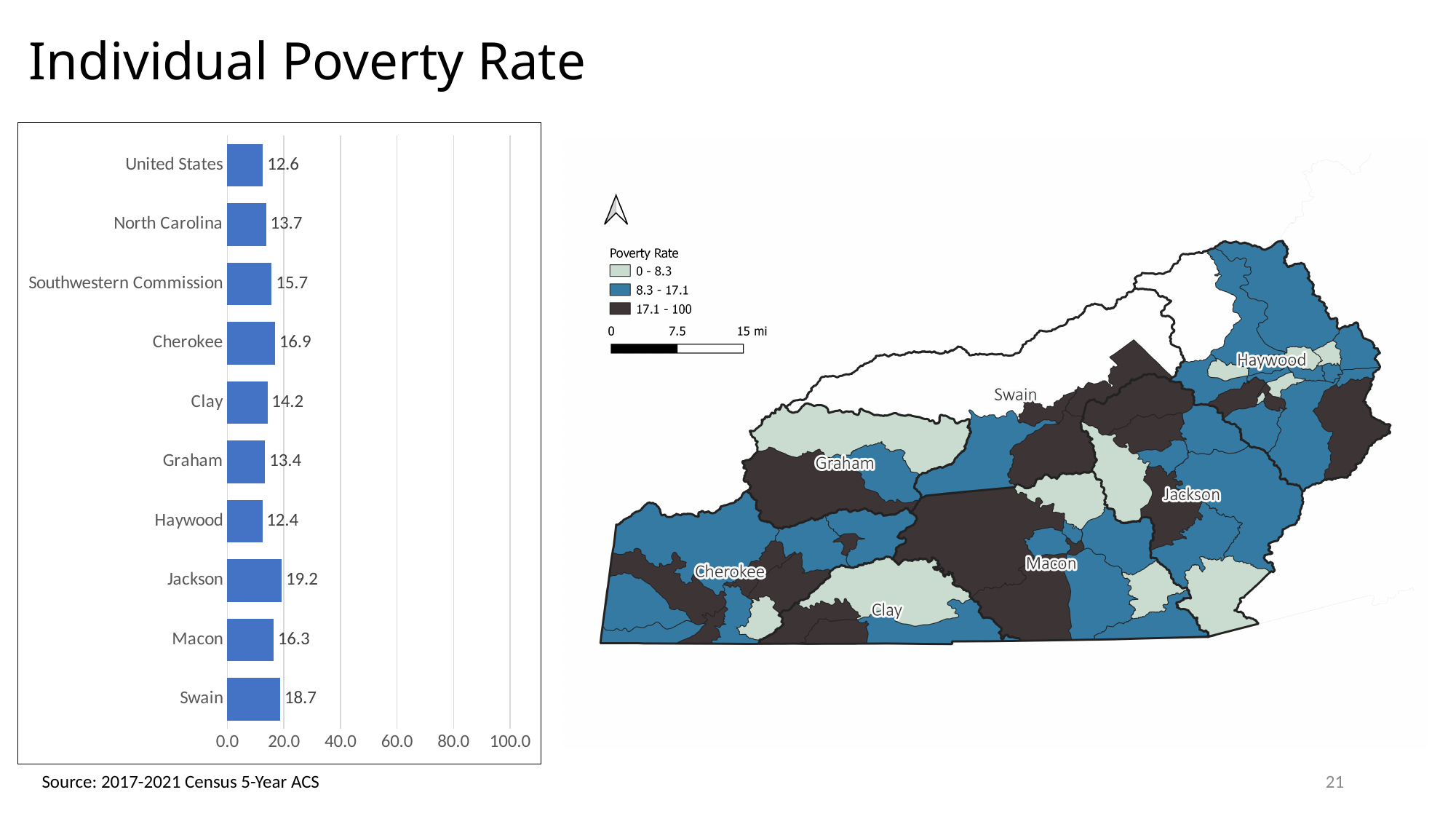
How many categories are shown in the bar chart? 10 Which category in the bar chart has the highest individual poverty rate? Jackson What is the difference between the poverty rates of North Carolina and the United States in the bar chart? 1.1 What is the difference between the poverty rates of Jackson and Haywood in the bar chart? 6.8 What is the individual poverty rate shown for Jackson in the bar chart? 19.2 In the bar chart, which has a higher poverty rate, Cherokee or Macon? Cherokee What is the individual poverty rate shown for the United States in the bar chart? 12.6 What is the individual poverty rate shown for the Southwestern Commission in the bar chart? 15.7 In the bar chart, is the value for Swain greater or less than 20.0? less Which category in the bar chart has the lowest individual poverty rate? Haywood What kind of chart is shown on the left of the slide? Bar chart What is the highest value labelled on the x axis of the bar chart? 100.0